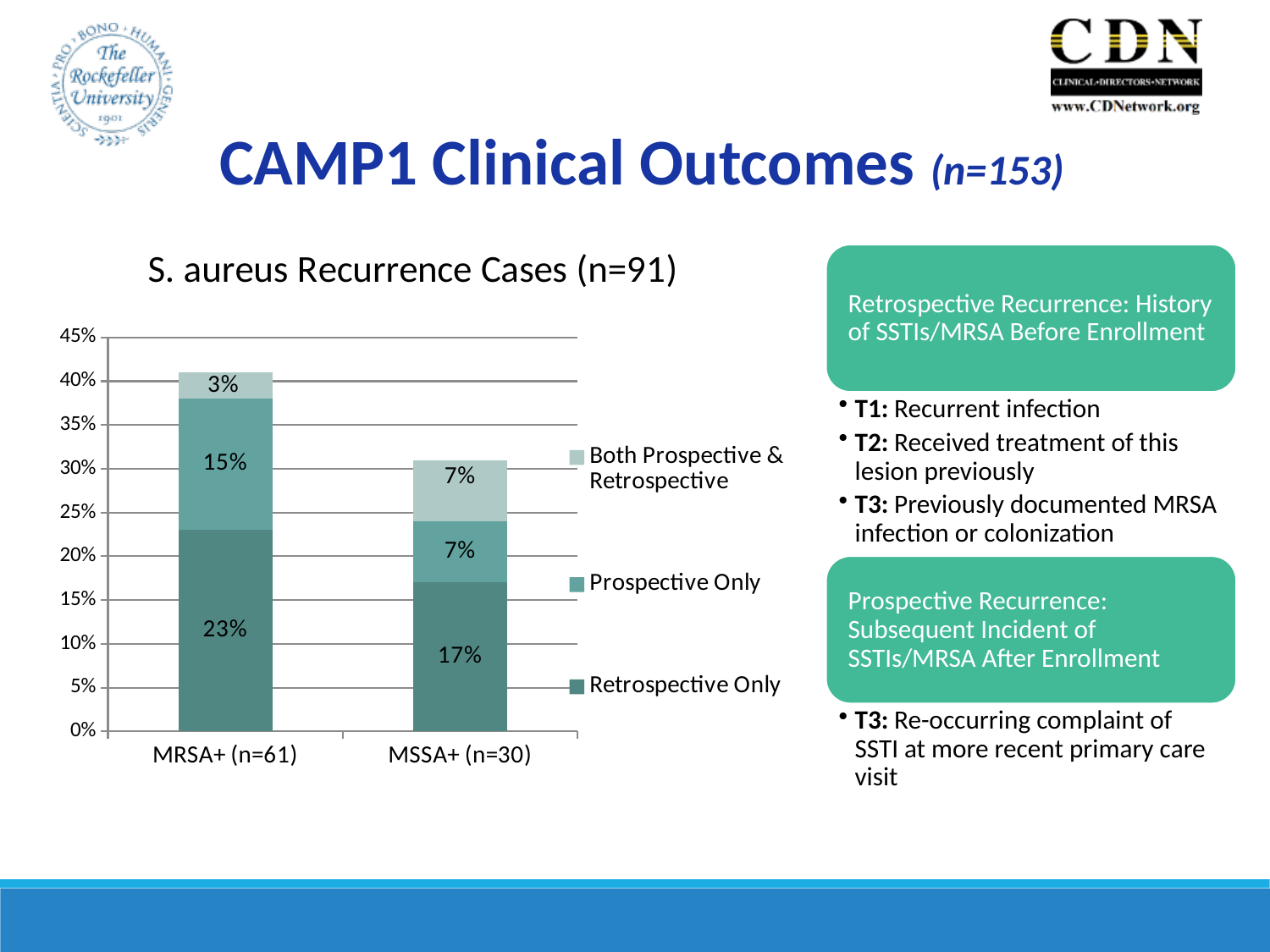
Which category has the larger Prospective Only value, MRSA+ (n=61) or MSSA+ (n=30)? MRSA+ (n=61) What is the value for Prospective Only in the MSSA+ (n=30) bar? 7% What is the difference between the Retrospective Only values for MRSA+ (n=61) and MSSA+ (n=30)? 6% What is the title of the chart? S. aureus Recurrence Cases (n=91) How many series does the legend list? 3 What is the value for Retrospective Only in the MSSA+ (n=30) bar? 17% Which category has the higher Both Prospective & Retrospective value? MSSA+ (n=30) What is the total of the stacked bar for MSSA+ (n=30)? 31% What is the value for Both Prospective & Retrospective in the MRSA+ (n=61) bar? 3% How many categories are shown on the x axis? 2 What is the value for Retrospective Only in the MRSA+ (n=61) bar? 23% What is the total of the stacked bar for MRSA+ (n=61)? 41%